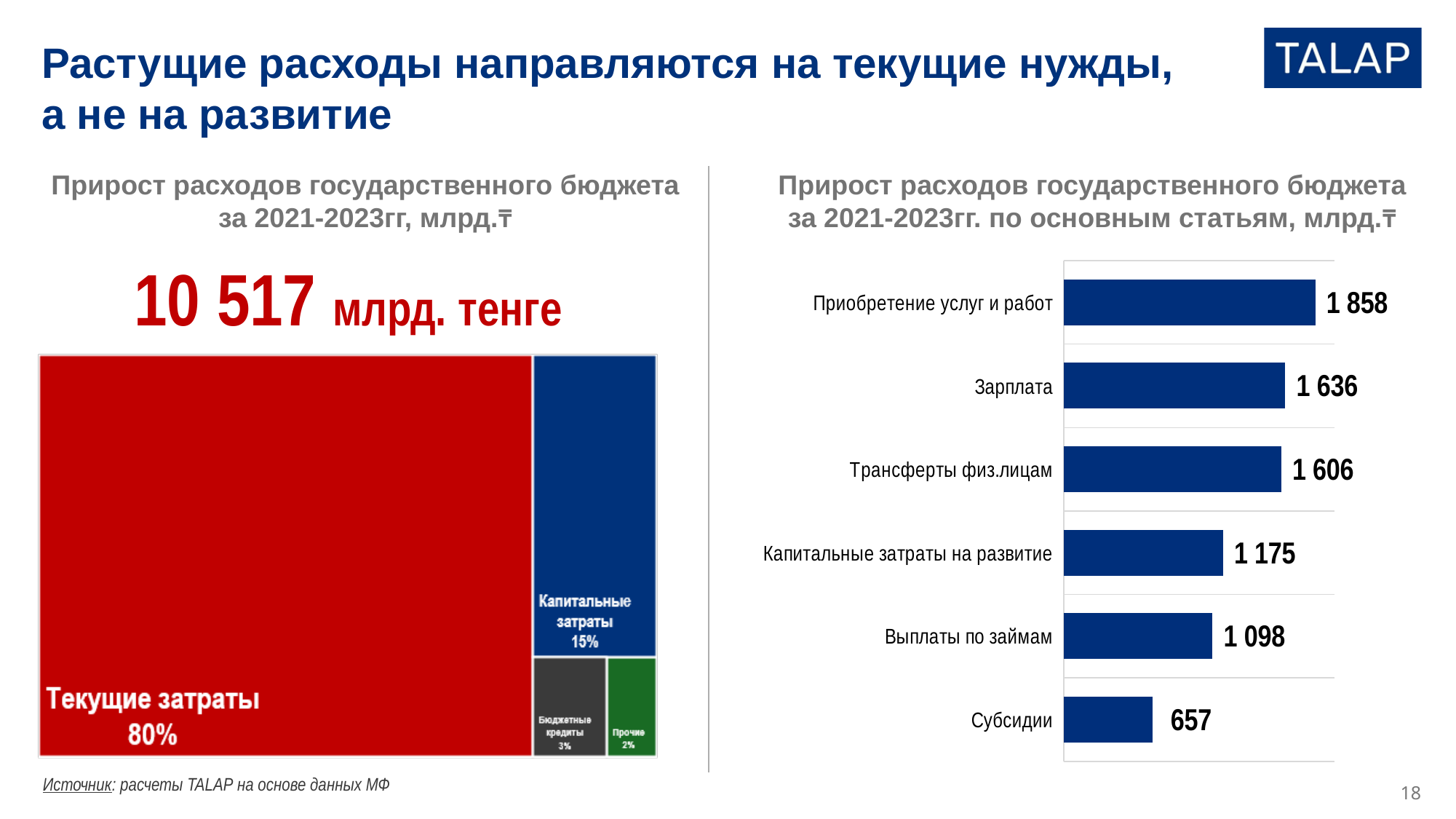
In the right-hand chart, what is the value for Капитальные затраты на развитие? 1 175 In the left-hand chart, what share is shown for Капитальные затраты? 15% In the right-hand chart, which category has the lowest value? Субсидии How many categories are shown in the right-hand bar chart? 6 In the left-hand chart (Прирост расходов государственного бюджета за 2021-2023гг), what share is shown for Текущие затраты? 80% In the right-hand chart, what is the difference between Приобретение услуг и работ and Выплаты по займам? 760 In the right-hand chart (Прирост расходов государственного бюджета за 2021-2023гг. по основным статьям), what is the value for Зарплата? 1 636 In the right-hand chart, what is the value for Субсидии? 657 In the right-hand chart, which is larger: Трансферты физ.лицам or Капитальные затраты на развитие? Трансферты физ.лицам What total value in млрд. тенге is shown above the left-hand chart? 10 517 What type of chart is the right-hand chart on the slide? Bar chart In the right-hand chart, which category has the highest value? Приобретение услуг и работ